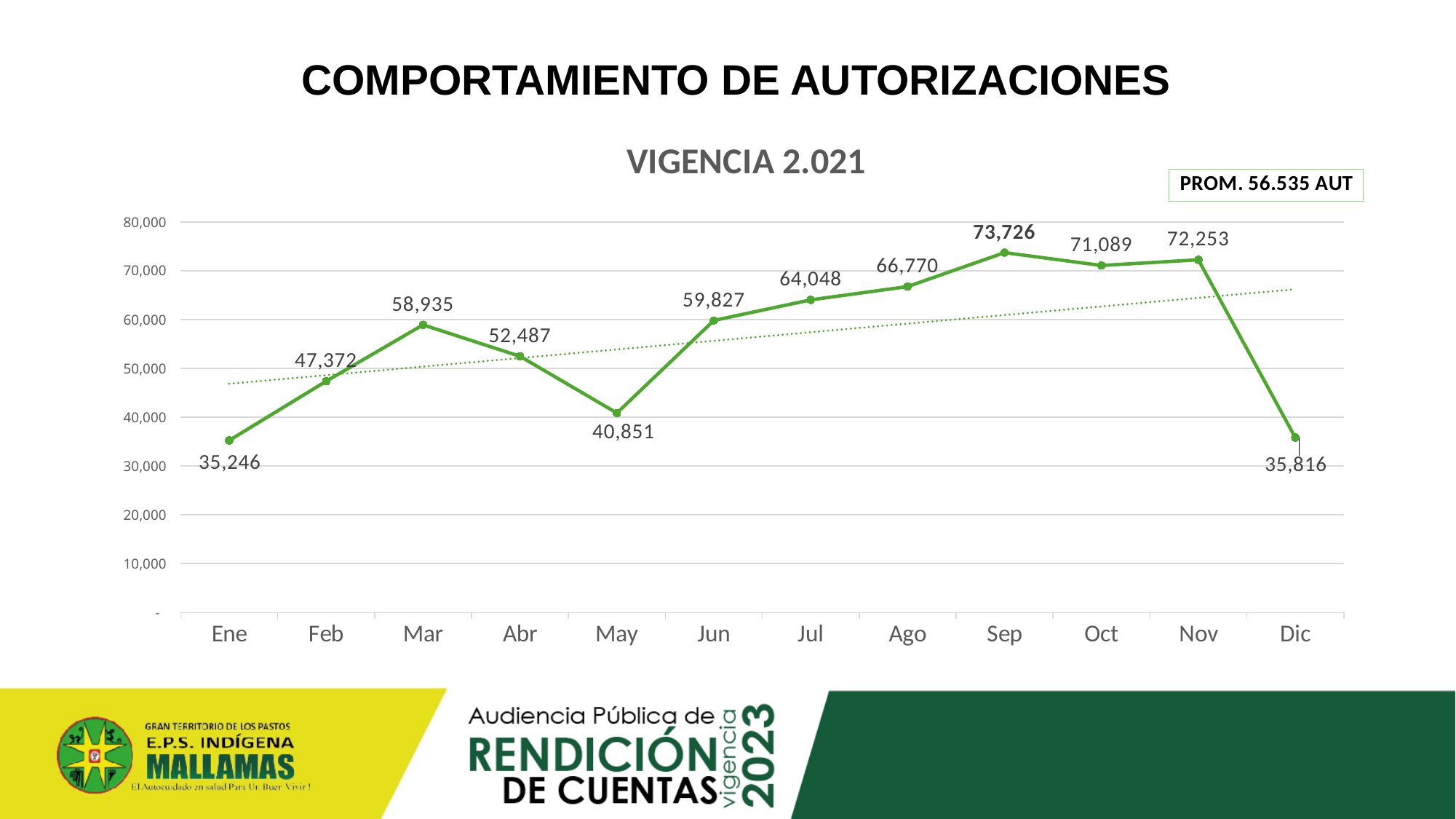
What is the difference between the values for Nov and Dic? 36,437 Which is larger, the value for Mar or the value for Abr? Mar What is the value for Sep? 73,726 What is the chart's title? VIGENCIA 2.021 Which month has the highest value? Sep Do the values rise or fall from Jun to Sep? rise What is the value for Ene? 35,246 Is the value for Jun greater or less than 50,000? greater How many months are plotted on the x axis? 12 What kind of chart is shown? line chart Which month has the lowest value? Ene What is the value for May? 40,851